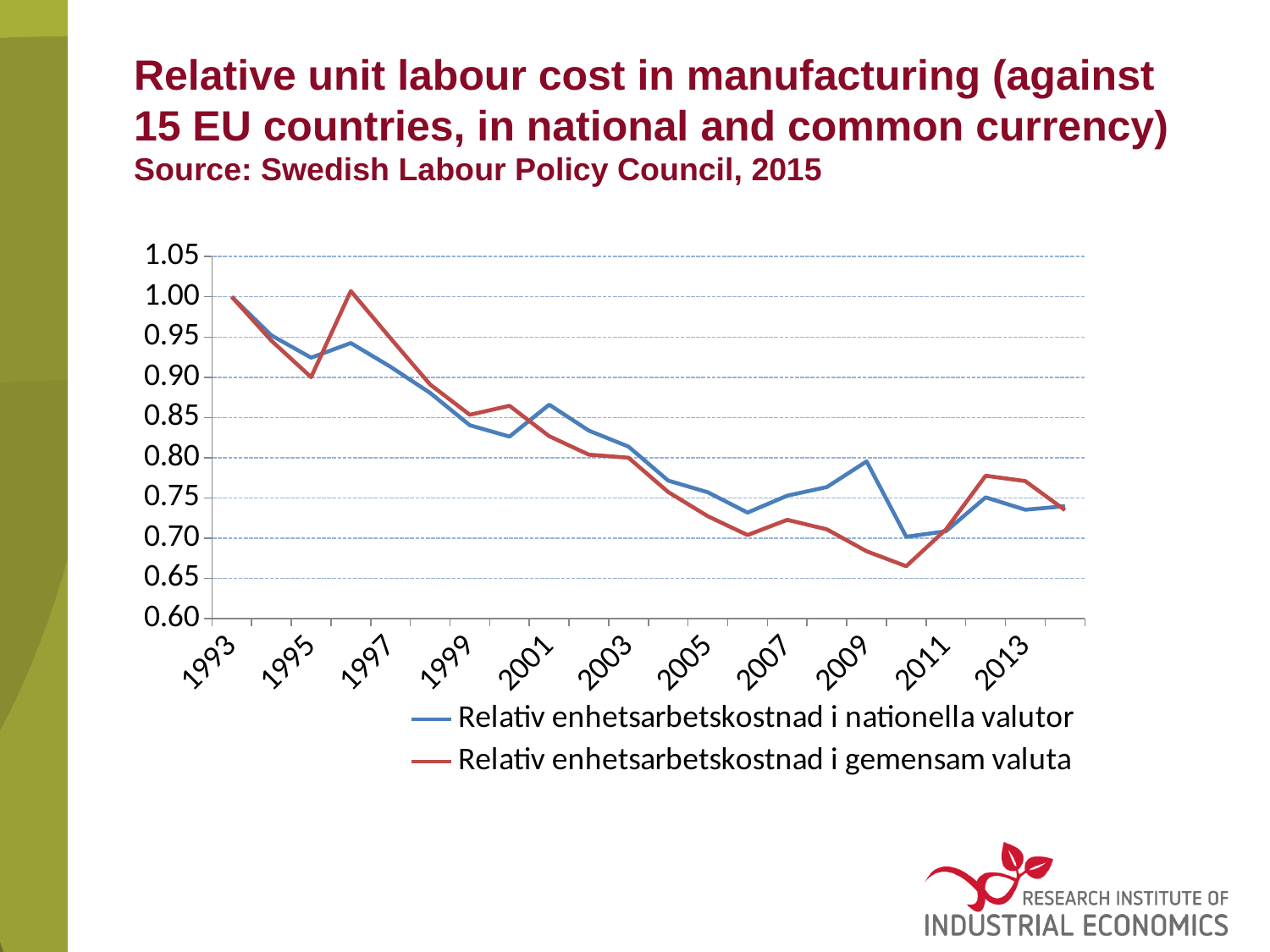
In which year is the 'Relativ enhetsarbetskostnad i gemensam valuta' series at its lowest? 2010 In 1996, which series has the higher value: 'Relativ enhetsarbetskostnad i nationella valutor' or 'Relativ enhetsarbetskostnad i gemensam valuta'? Relativ enhetsarbetskostnad i gemensam valuta Overall, do the values of the 'Relativ enhetsarbetskostnad i nationella valutor' series rise or fall from 1993 to the end of the period? Fall What kind of chart is shown on the slide? Line chart How many series does the legend list? 2 In 2009, which series has the higher value: 'Relativ enhetsarbetskostnad i nationella valutor' or 'Relativ enhetsarbetskostnad i gemensam valuta'? Relativ enhetsarbetskostnad i nationella valutor Is the value of the 'Relativ enhetsarbetskostnad i gemensam valuta' series in 1996 greater or less than 0.95? greater What is the value of both series in 1993? 1.00 Is the value of the 'Relativ enhetsarbetskostnad i gemensam valuta' series in 2010 greater or less than 0.70? less What source is cited for the chart? Swedish Labour Policy Council, 2015 Is the value of the 'Relativ enhetsarbetskostnad i nationella valutor' series in 1997 greater or less than 0.90? greater Which colour is used for the 'Relativ enhetsarbetskostnad i gemensam valuta' series? Red